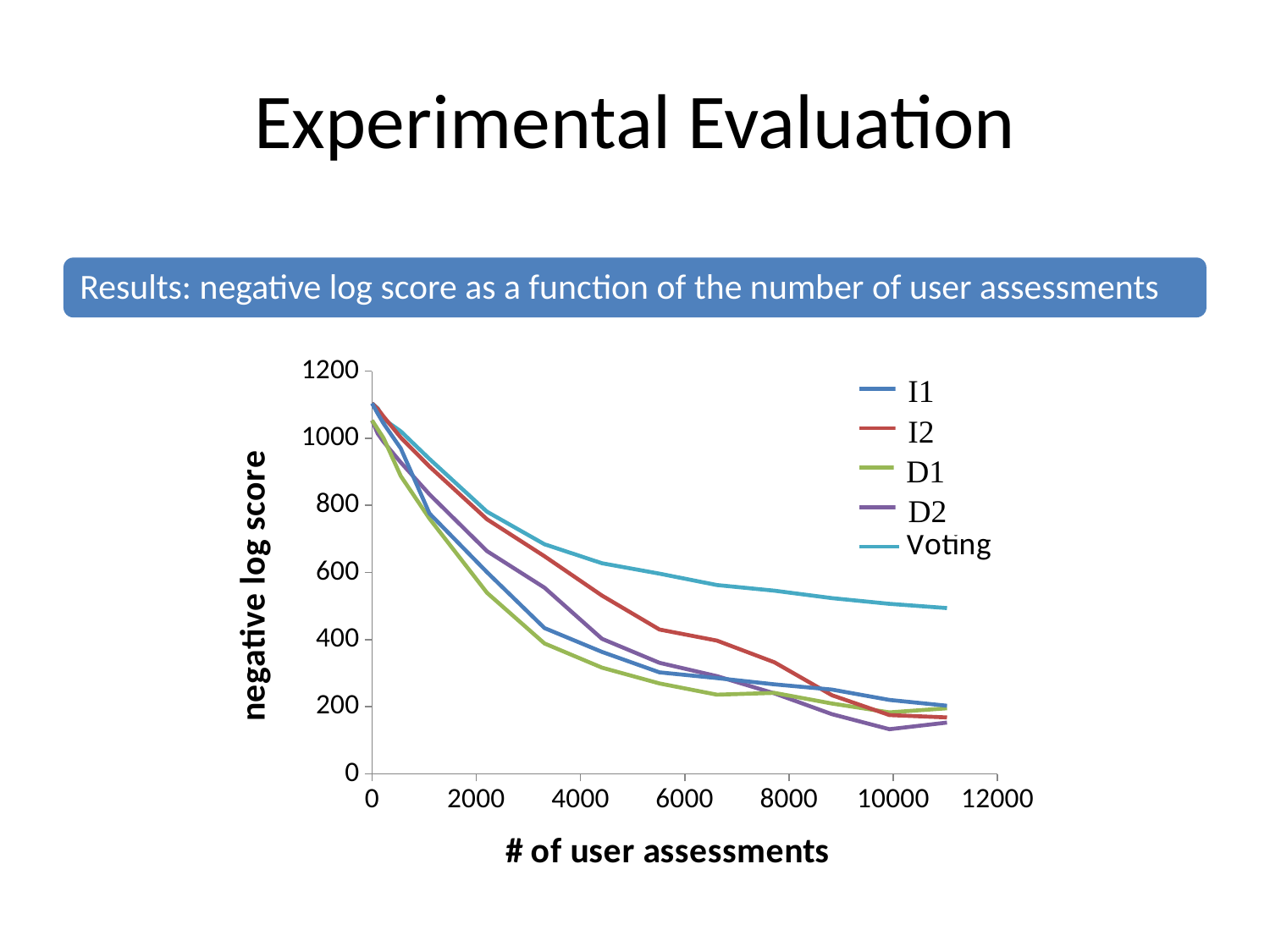
Which series are listed in the legend? I1, I2, D1, D2, Voting What is the label of the y axis? negative log score Which series has the lowest negative log score at 10000 user assessments? D2 Is the value for Voting at 10000 user assessments greater or less than 400? greater Is the value for D1 at 4000 user assessments greater or less than 400? less Is the value for Voting at 11000 user assessments greater or less than 600? less What kind of chart is shown on the slide? line chart At 6000 user assessments, which series has the larger negative log score, I2 or D1? I2 Does the Voting series rise or fall as the number of user assessments increases? fall Which series has the highest negative log score at 11000 user assessments? Voting At 8000 user assessments, which series has the larger negative log score, Voting or D1? Voting How many series does the legend list? 5